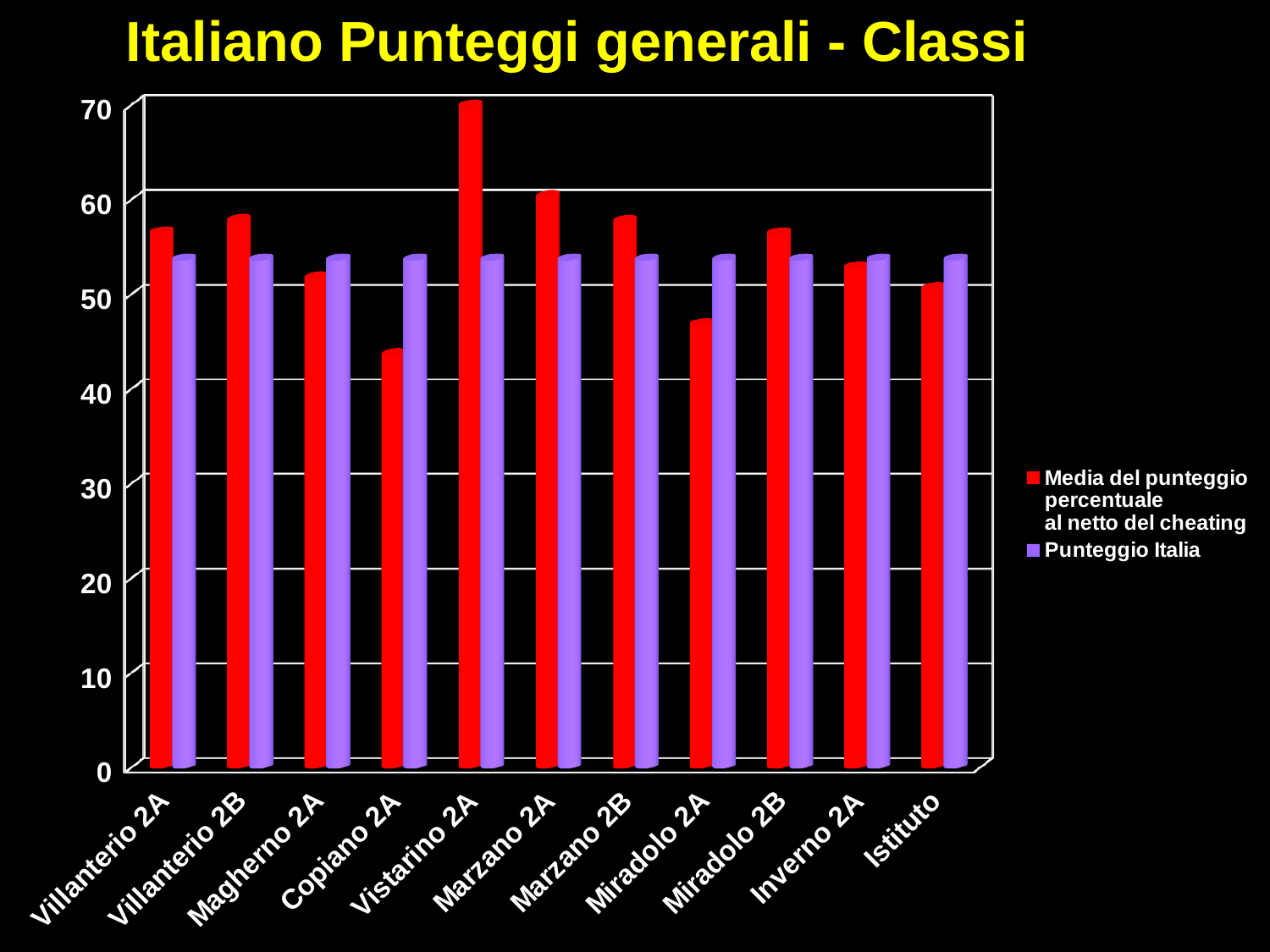
Is the 'Media del punteggio percentuale al netto del cheating' value for Miradolo 2A greater or less than 50? less Is the 'Media del punteggio percentuale al netto del cheating' value for Vistarino 2A greater or less than 60? greater Which colour represents the 'Punteggio Italia' series? purple Which category has the lowest value for 'Media del punteggio percentuale al netto del cheating'? Copiano 2A For Copiano 2A, which is larger: 'Media del punteggio percentuale al netto del cheating' or 'Punteggio Italia'? Punteggio Italia What kind of chart is shown on the slide? bar chart For Vistarino 2A, which is larger: 'Media del punteggio percentuale al netto del cheating' or 'Punteggio Italia'? Media del punteggio percentuale al netto del cheating How many series does the legend list? 2 How many categories are shown on the x axis? 11 Which category has the highest value for 'Media del punteggio percentuale al netto del cheating'? Vistarino 2A Is the 'Media del punteggio percentuale al netto del cheating' value for Copiano 2A greater or less than 50? less What is the title of the chart? Italiano Punteggi generali - Classi